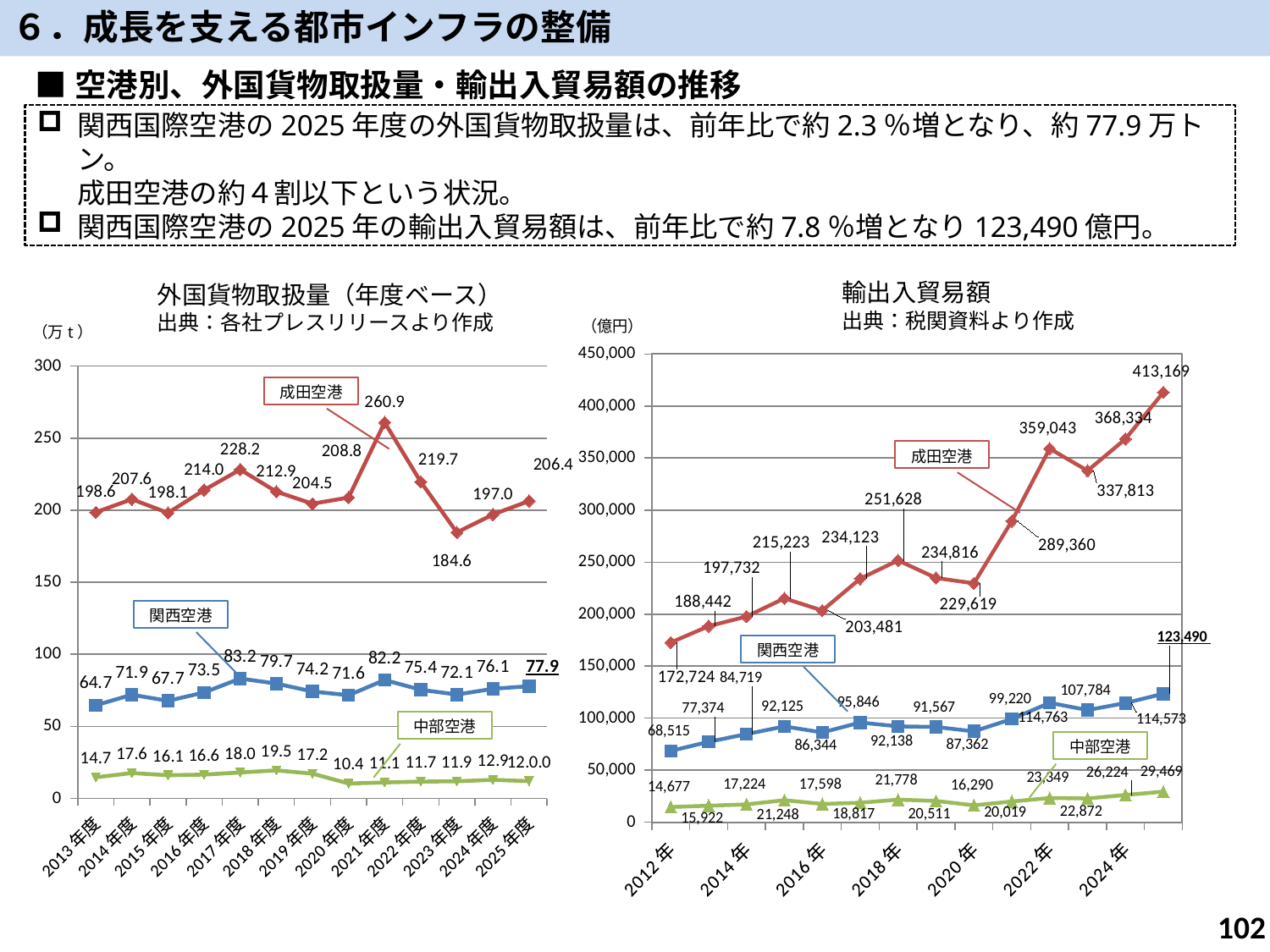
In the 輸出入貿易額 chart, what is the difference between the 関西空港 values for 2025年 and 2024年? 8,917 In the 輸出入貿易額 chart, which is larger: the 関西空港 value in 2023年 or in 2024年? 2024年 In the 輸出入貿易額 chart, what is the value for 中部空港 in 2012年? 14,677 In the 外国貨物取扱量（年度ベース） chart, how many fiscal years are shown on the x axis? 13 In the 外国貨物取扱量（年度ベース） chart, what is the value for 成田空港 in 2021年度? 260.9 In the 輸出入貿易額 chart, what is the value for 成田空港 in 2025年? 413,169 In the 外国貨物取扱量（年度ベース） chart, what is the value for 関西空港 in 2025年度? 77.9 In the 外国貨物取扱量（年度ベース） chart, in which year is the 成田空港 value lowest? 2023年度 What unit is shown on the y axis of the 輸出入貿易額 chart? 億円 In the 輸出入貿易額 chart, is the 成田空港 value for 2022年 greater or less than 300,000? greater In the 外国貨物取扱量（年度ベース） chart, what is the difference between the 関西空港 values for 2017年度 and 2013年度? 18.5 What type of chart is the 外国貨物取扱量（年度ベース） chart? Line chart